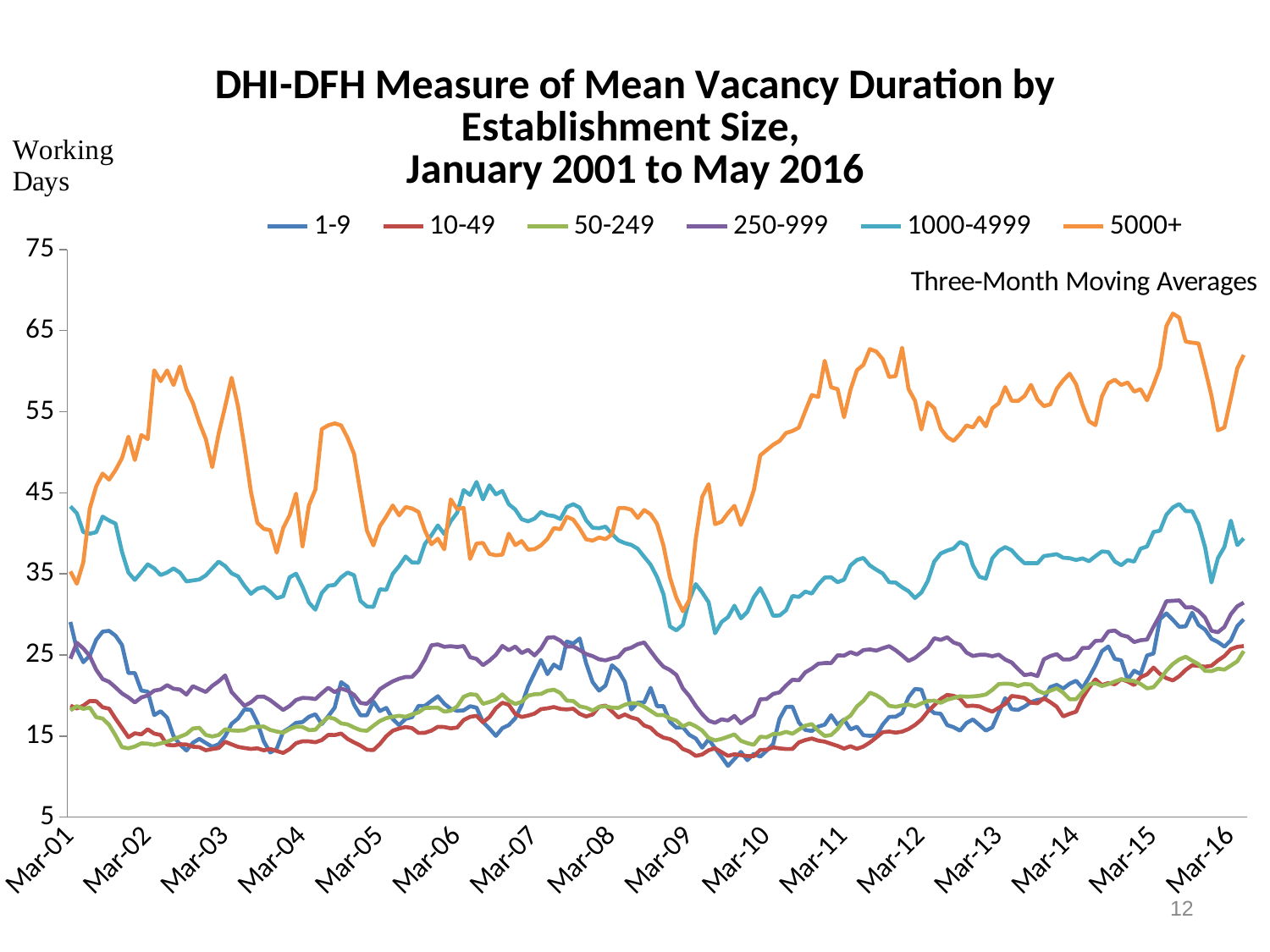
Does the 5000+ series rise or fall between Mar-09 and Mar-11? rise What unit is shown on the vertical axis label? Working Days Is the value for the 1-9 series at Mar-01 greater or less than 25? greater Does the 1-9 series rise or fall between Mar-01 and Mar-03? fall Which establishment-size series has the highest values across most of the chart? 5000+ Around Mar-11, which series is higher, 5000+ or 1000-4999? 5000+ What period does the chart title say the data covers? January 2001 to May 2016 What kind of chart is shown on the slide? line chart At Mar-16, which series is larger, 250-999 or 50-249? 250-999 Is the peak value of the 1000-4999 series greater or less than 55? less How many series does the legend list? 6 Is the highest value reached by the 5000+ series greater or less than 65? greater